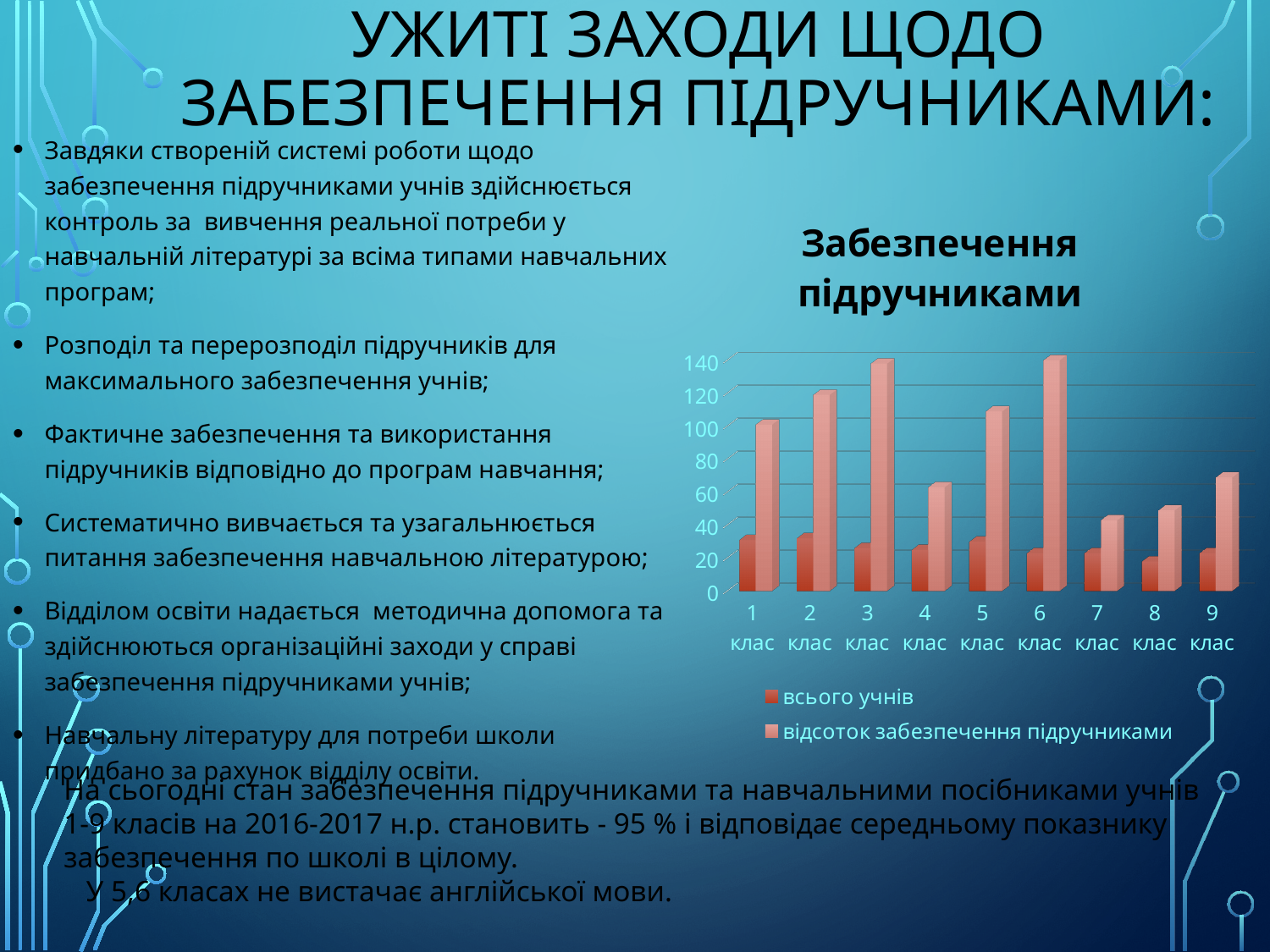
What is the title of the chart? Забезпечення підручниками Which has a larger value of "всього учнів": 2 клас or 8 клас? 2 клас Is the value of "всього учнів" for 1 клас greater or less than 40? less Is the value of "відсоток забезпечення підручниками" for 4 клас greater or less than 80? less What are the two series named in the chart legend? всього учнів; відсоток забезпечення підручниками What kind of chart is shown on the slide? Bar chart How many series does the chart legend list? 2 How many categories (classes) are shown on the x axis of the chart? 9 Is the value of "відсоток забезпечення підручниками" for 2 клас greater or less than 100? greater Which has a larger value of "відсоток забезпечення підручниками": 5 клас or 9 клас? 5 клас Which has a larger value of "відсоток забезпечення підручниками": 2 клас or 4 клас? 2 клас